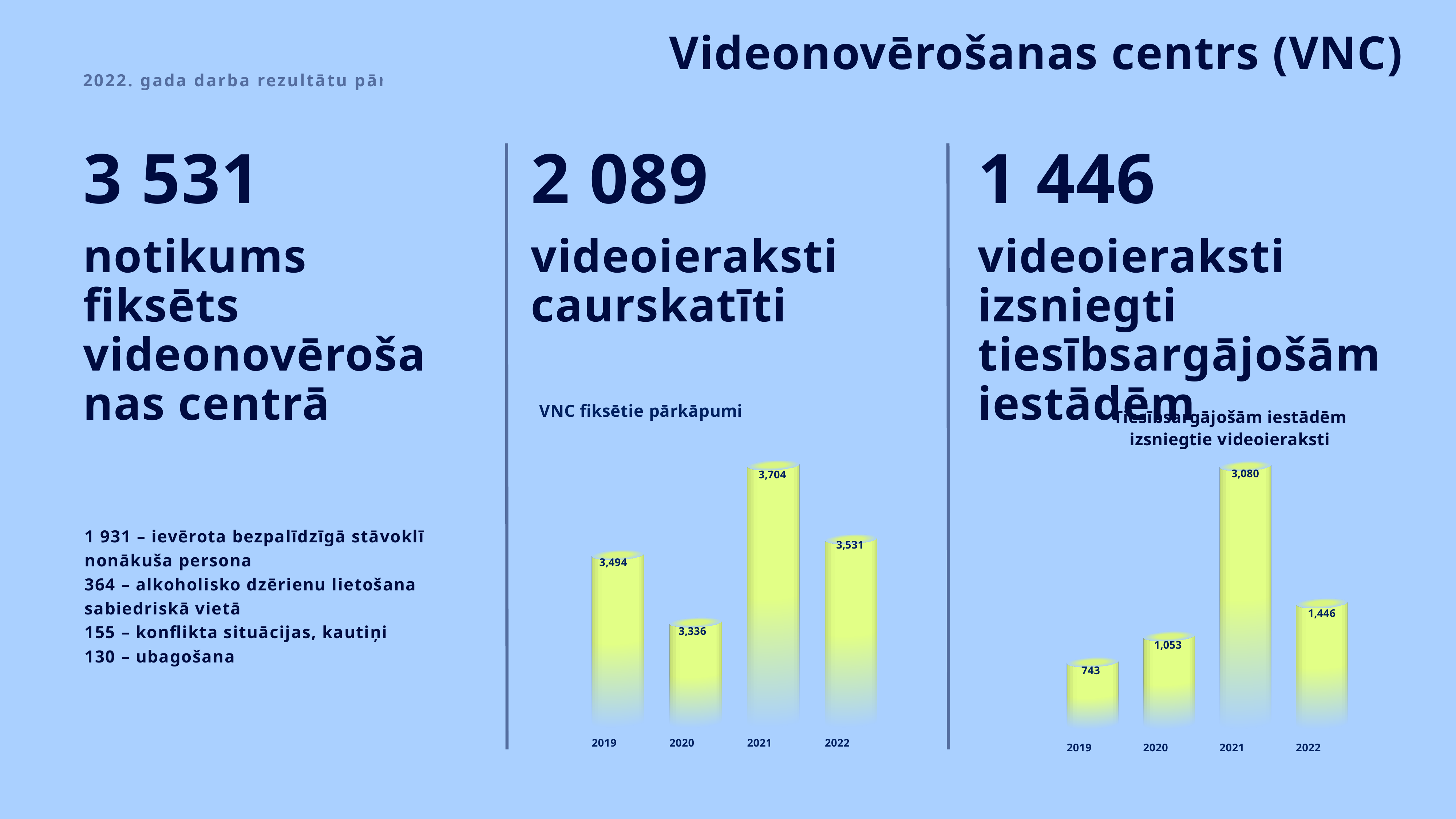
In the chart titled "VNC fiksētie pārkāpumi", how many years are shown? 4 In the chart titled "Tiesībsargājošām iestādēm izsniegtie videoieraksti", which year has the highest value? 2021 What kind of chart is the chart titled "VNC fiksētie pārkāpumi"? bar chart In the chart titled "VNC fiksētie pārkāpumi", what is the difference between the values for 2021 and 2022? 173 In the chart titled "Tiesībsargājošām iestādēm izsniegtie videoieraksti", what is the value for 2019? 743 In the chart titled "VNC fiksētie pārkāpumi", what is the value for 2021? 3,704 In the chart titled "VNC fiksētie pārkāpumi", which year has the lowest value? 2020 In the chart titled "Tiesībsargājošām iestādēm izsniegtie videoieraksti", which is larger, the value for 2020 or the value for 2022? 2022 In the chart titled "VNC fiksētie pārkāpumi", what is the value for 2020? 3,336 In the chart titled "Tiesībsargājošām iestādēm izsniegtie videoieraksti", what is the value for 2022? 1,446 In the chart titled "Tiesībsargājošām iestādēm izsniegtie videoieraksti", what is the difference between the values for 2021 and 2020? 2,027 In the chart titled "VNC fiksētie pārkāpumi", which year has the highest value? 2021